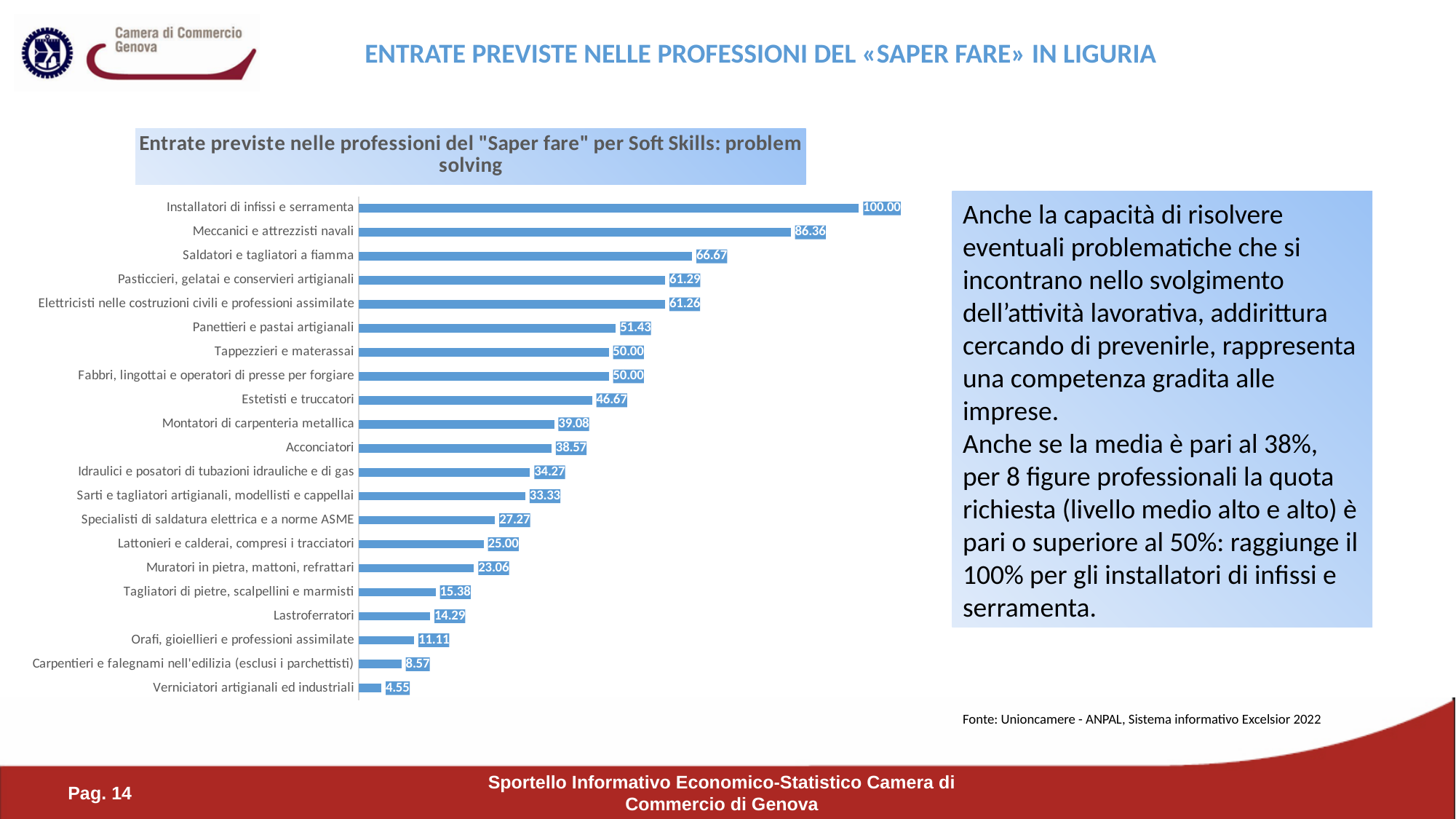
Which is larger, the value for Acconciatori or the value for Idraulici e posatori di tubazioni idrauliche e di gas? Acconciatori Which is larger, the value for Orafi, gioiellieri e professioni assimilate or the value for Tagliatori di pietre, scalpellini e marmisti? Tagliatori di pietre, scalpellini e marmisti Which category has the highest value? Installatori di infissi e serramenta What value is shown for Muratori in pietra, mattoni, refrattari? 23.06 What is the difference between the values for Lattonieri e calderai, compresi i tracciatori and Lastroferratori? 10.71 What value is shown for Meccanici e attrezzisti navali? 86.36 What is the difference between the values for Installatori di infissi e serramenta and Saldatori e tagliatori a fiamma? 33.33 What kind of chart is shown on the slide? Bar chart How many categories are plotted in the chart? 21 What value is shown for Estetisti e truccatori? 46.67 Which category has the lowest value? Verniciatori artigianali ed industriali Which soft skill does the chart title refer to? Problem solving